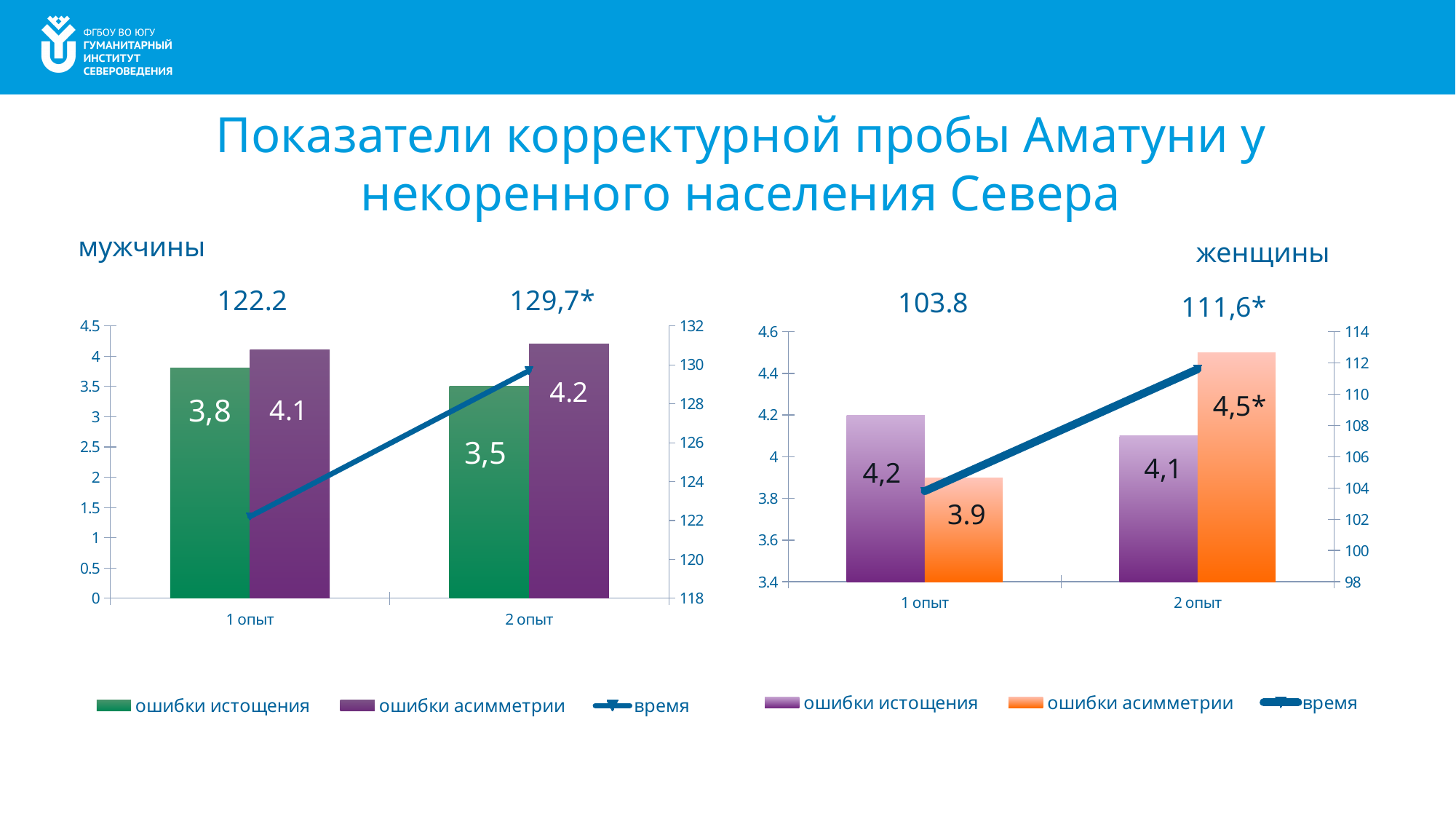
How many series does the legend of the женщины chart list? 3 On the мужчины chart, which is larger for 1 опыт: ошибки истощения or ошибки асимметрии? ошибки асимметрии How many categories are on the x axis of the мужчины chart? 2 On the женщины chart, what colour are the ошибки асимметрии bars? orange On the мужчины chart, what is the value of ошибки истощения for 1 опыт? 3,8 On the женщины chart, what is the value of ошибки истощения for 2 опыт? 4,1 On the мужчины chart, what is the время value shown above 2 опыт? 129,7* On the женщины chart, what is the время value shown above 1 опыт? 103.8 On the мужчины chart, what is the value of ошибки асимметрии for 2 опыт? 4.2 On the мужчины chart, does the время line rise or fall from 1 опыт to 2 опыт? rise On the женщины chart, which is larger for 1 опыт: ошибки истощения or ошибки асимметрии? ошибки истощения On the женщины chart, what is the value of ошибки асимметрии for 1 опыт? 3.9